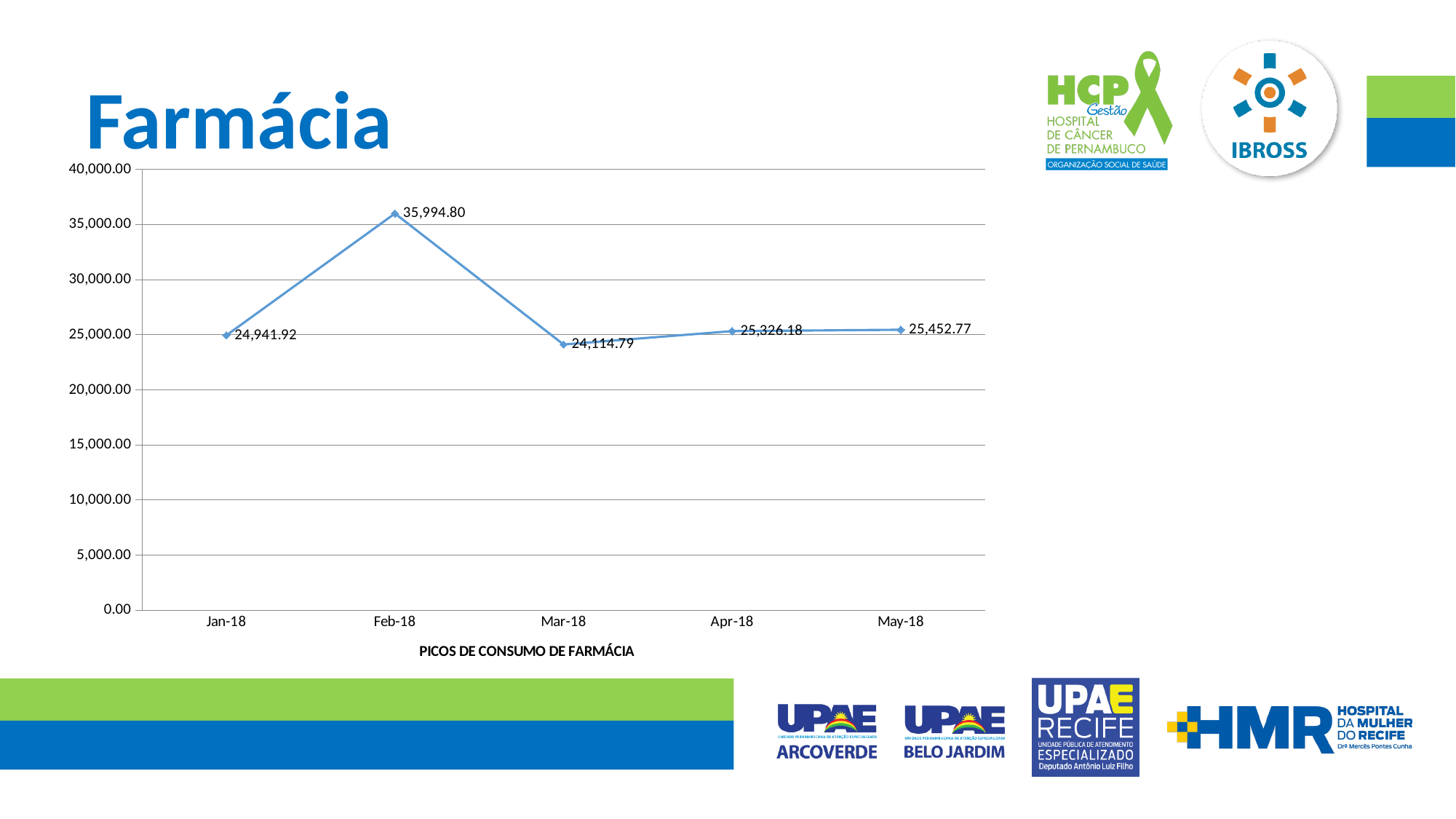
Which is larger, the value for Apr-18 or the value for May-18? May-18 What is the value for Feb-18? 35,994.80 What is the difference between the values for Apr-18 and Mar-18? 1,211.39 What is the value for Jan-18? 24,941.92 What is the difference between the values for Feb-18 and Jan-18? 11,052.88 What is the value for May-18? 25,452.77 What kind of chart is shown on the slide? Line chart Which month has the lowest value? Mar-18 How many months are plotted on the chart? 5 Which month has the highest value? Feb-18 What is the value for Mar-18? 24,114.79